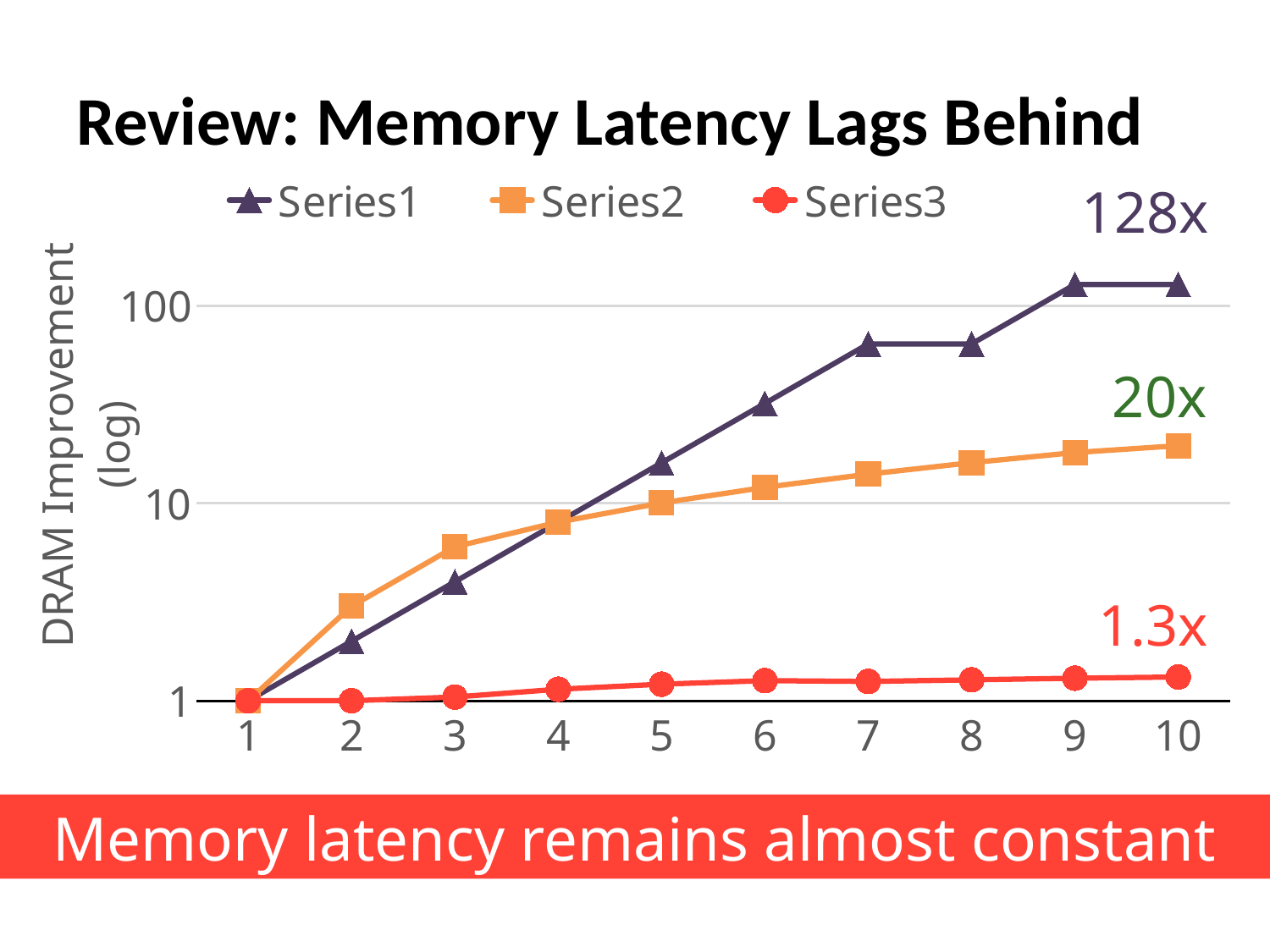
What is the value of Series1 at x = 10, as labelled on the chart? 128x What is the value of Series2 at x = 10, as labelled on the chart? 20x How many series does the legend list? 3 At x = 3, which series has the larger value, Series1 or Series2? Series2 What is the title of the y axis? DRAM Improvement (log) How many points are plotted along the x axis for each series? 10 What is the value of Series3 at x = 10, as labelled on the chart? 1.3x Is the value of Series2 at x = 2 greater or less than 10? less Is the value of Series1 at x = 7 greater or less than 10? greater Is the value of Series3 at x = 8 greater or less than 10? less What kind of chart is shown on the slide? line chart Which series has the lowest value at x = 10? Series3